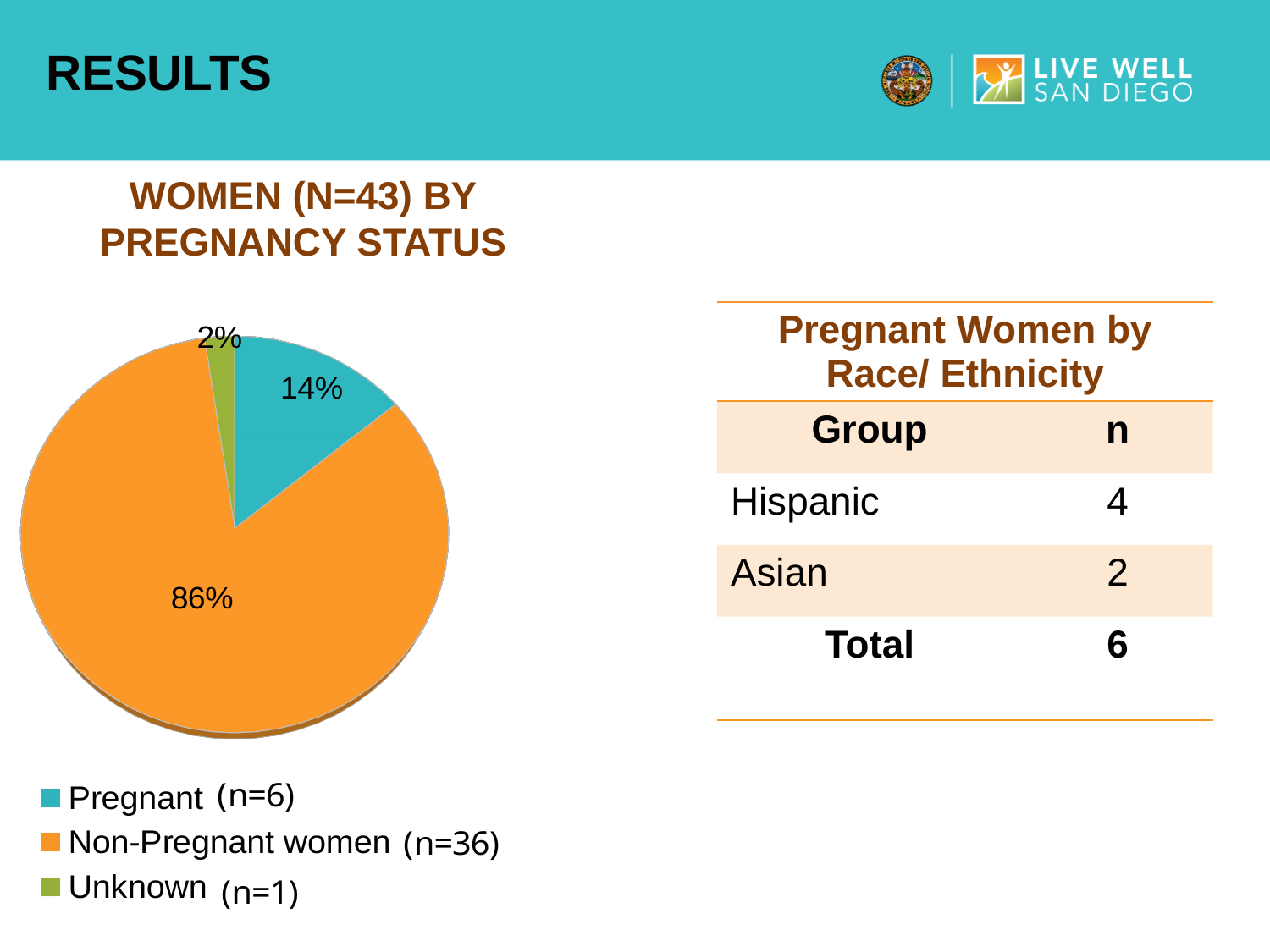
What percentage of women have Unknown pregnancy status in the pie chart? 2% What percentage of women are Non-Pregnant women in the pie chart? 86% What is the title of the pie chart? WOMEN (N=43) BY PREGNANCY STATUS How many categories does the pie chart show? 3 What type of chart is shown on the slide? Pie chart What colour represents Non-Pregnant women in the pie chart? Orange What is the difference in percentage points between Non-Pregnant women and Pregnant in the pie chart? 72 According to the legend, how many women are in the Pregnant category? n=6 Which category has the smallest share of the pie chart? Unknown Which is larger in the pie chart, the Pregnant share or the Unknown share? Pregnant Which category has the largest share of the pie chart? Non-Pregnant women What percentage of women are Pregnant in the pie chart? 14%